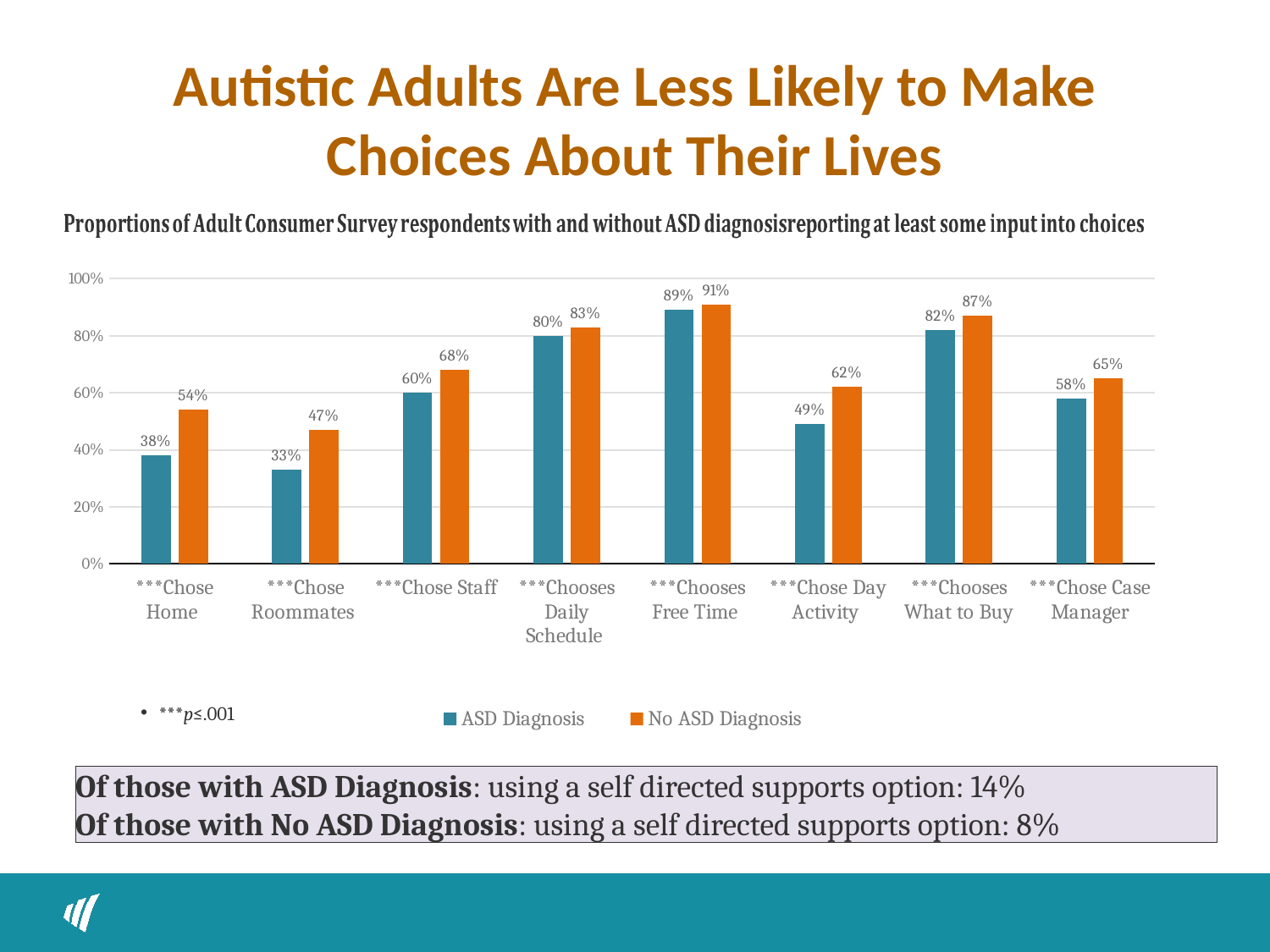
What is the difference between the No ASD Diagnosis and ASD Diagnosis values in the Chose Home category? 16% What is the value for No ASD Diagnosis in the Chose Day Activity category? 62% How many categories are shown on the x axis? 8 Which is larger in the Chose Staff category: the ASD Diagnosis value or the No ASD Diagnosis value? No ASD Diagnosis Which colour represents the No ASD Diagnosis series? Orange Which category has the lowest value for the ASD Diagnosis series? Chose Roommates Which category has the highest value for the No ASD Diagnosis series? Chooses Free Time What is the value for ASD Diagnosis in the Chose Home category? 38% What is the value for ASD Diagnosis in the Chooses What to Buy category? 82% How many series does the legend list? 2 What is the difference between the No ASD Diagnosis and ASD Diagnosis values in the Chose Roommates category? 14% What kind of chart is shown on the slide? Bar chart